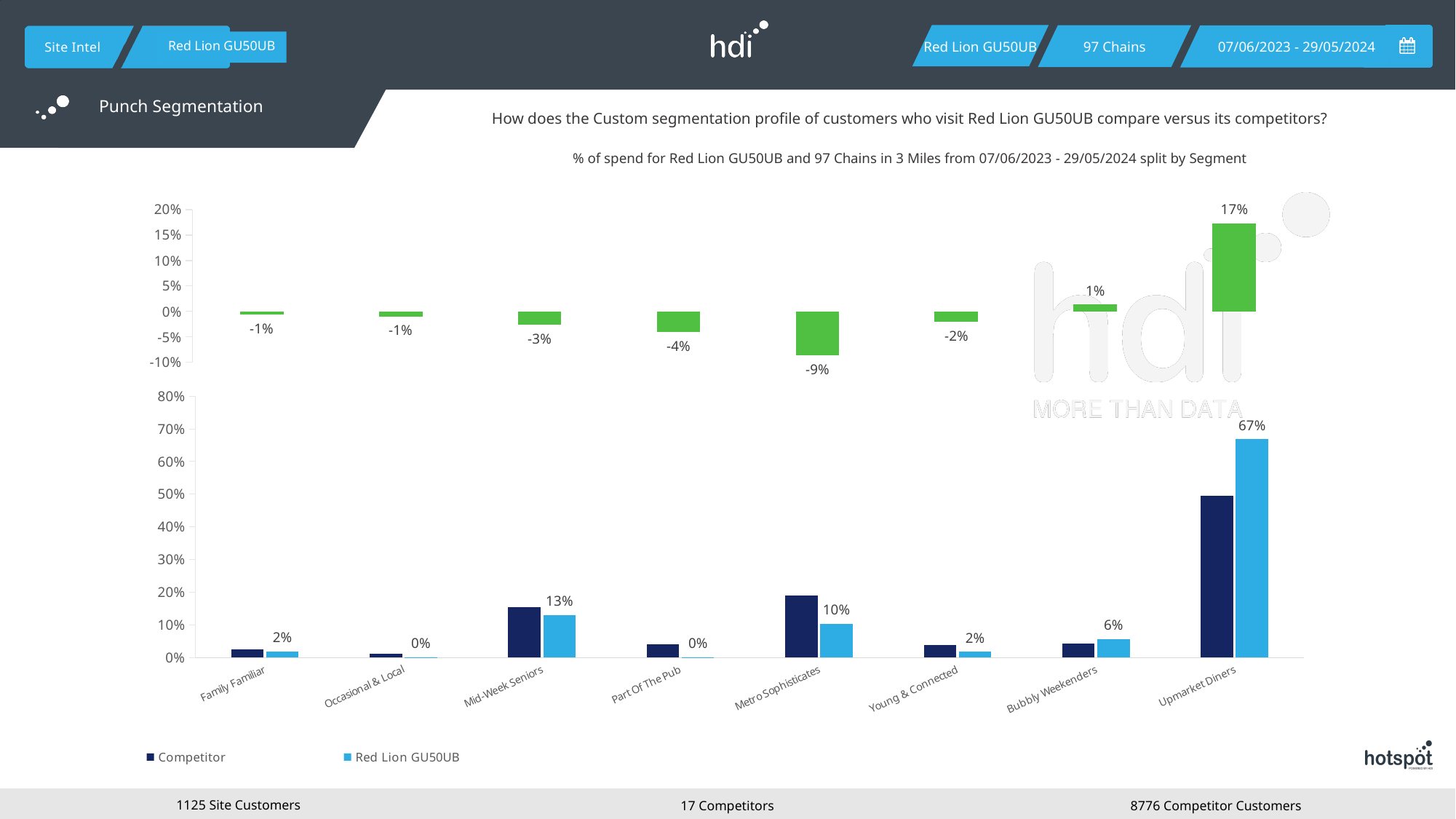
In the top chart, what is the value shown for Upmarket Diners? 17% In the bottom chart, for Metro Sophisticates, which is larger: the Competitor value or the Red Lion GU50UB value? Competitor In the top chart, what is the value shown for Metro Sophisticates? -9% How many series does the legend of the bottom chart list? 2 How many segments are shown on the x axis of the bottom chart? 8 In the bottom chart, what is the value for Red Lion GU50UB in the Mid-Week Seniors segment? 13% In the bottom chart, what is the difference between the Red Lion GU50UB values for Upmarket Diners and Mid-Week Seniors? 54% In the bottom chart, which segment has the highest value for Red Lion GU50UB? Upmarket Diners In the bottom chart, what is the value for Red Lion GU50UB in the Upmarket Diners segment? 67% What kind of chart is the bottom chart? bar chart In the bottom chart, is the Competitor value for Upmarket Diners greater or less than 40%? greater In the top chart, which segment has the lowest value? Metro Sophisticates